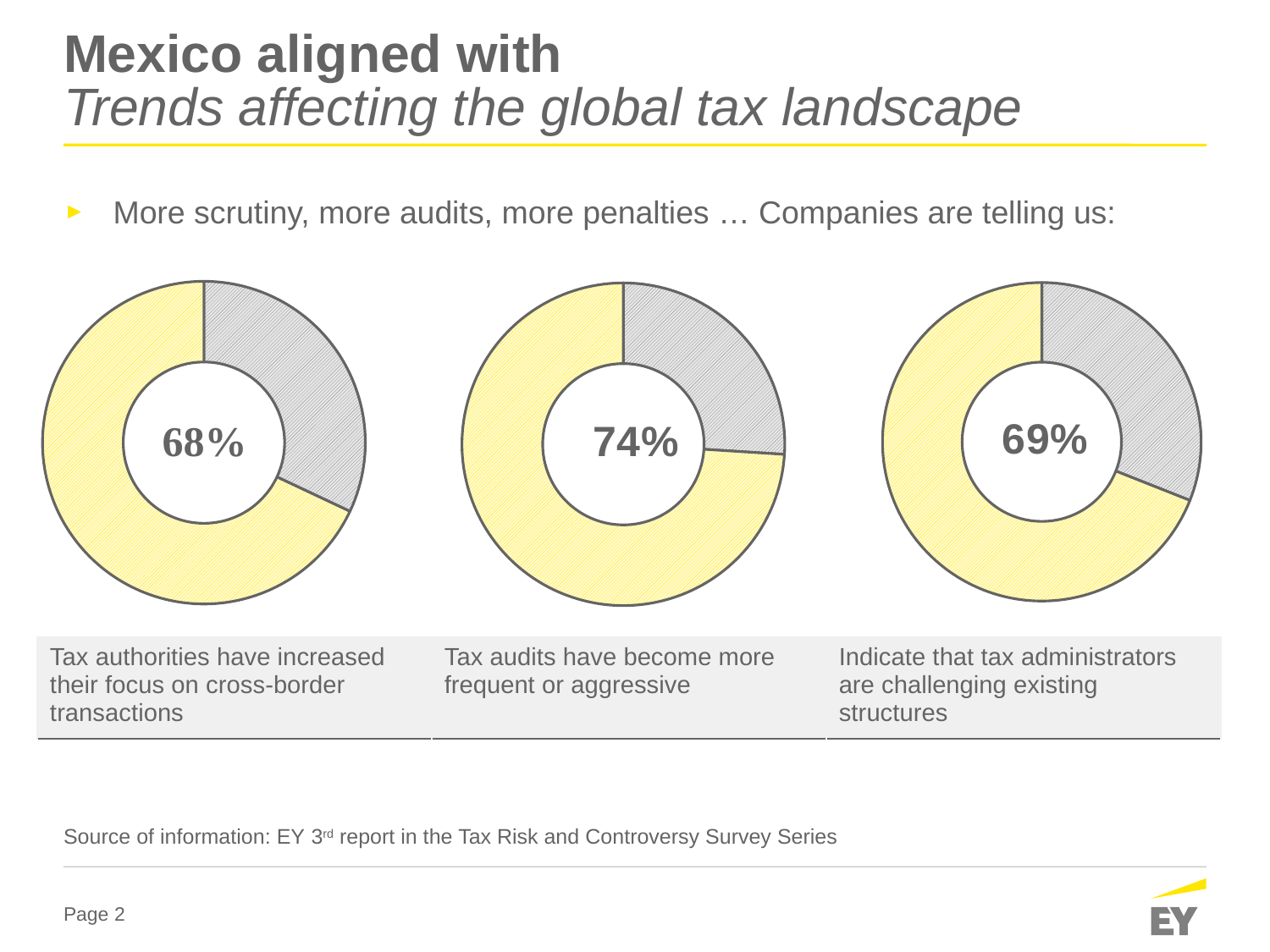
What percentage is shown in the right donut chart, about tax administrators challenging existing structures? 69% What kind of chart is used to display the three percentages on the slide? Donut (pie) chart In the left donut chart, what share of the ring is taken by the yellow highlighted slice? 68% What percentage is shown in the middle donut chart, about tax audits becoming more frequent or aggressive? 74% What percentage is shown in the left donut chart, about tax authorities increasing their focus on cross-border transactions? 68% What is the difference between the percentage in the right chart (challenging existing structures) and the left chart (focus on cross-border transactions)? 1 percentage point Which of the three donut charts shows the lowest percentage? Tax authorities have increased their focus on cross-border transactions (68%) How many donut charts are shown on the slide? 3 Which is larger: the percentage in the middle chart (tax audits more frequent or aggressive) or the right chart (challenging existing structures)? The middle chart (74%) Which of the three donut charts shows the highest percentage? Tax audits have become more frequent or aggressive (74%) What is the difference between the percentage in the middle chart (tax audits more frequent or aggressive) and the left chart (focus on cross-border transactions)? 6 percentage points What colour is used for the highlighted slice representing the stated percentage in each donut chart? Yellow